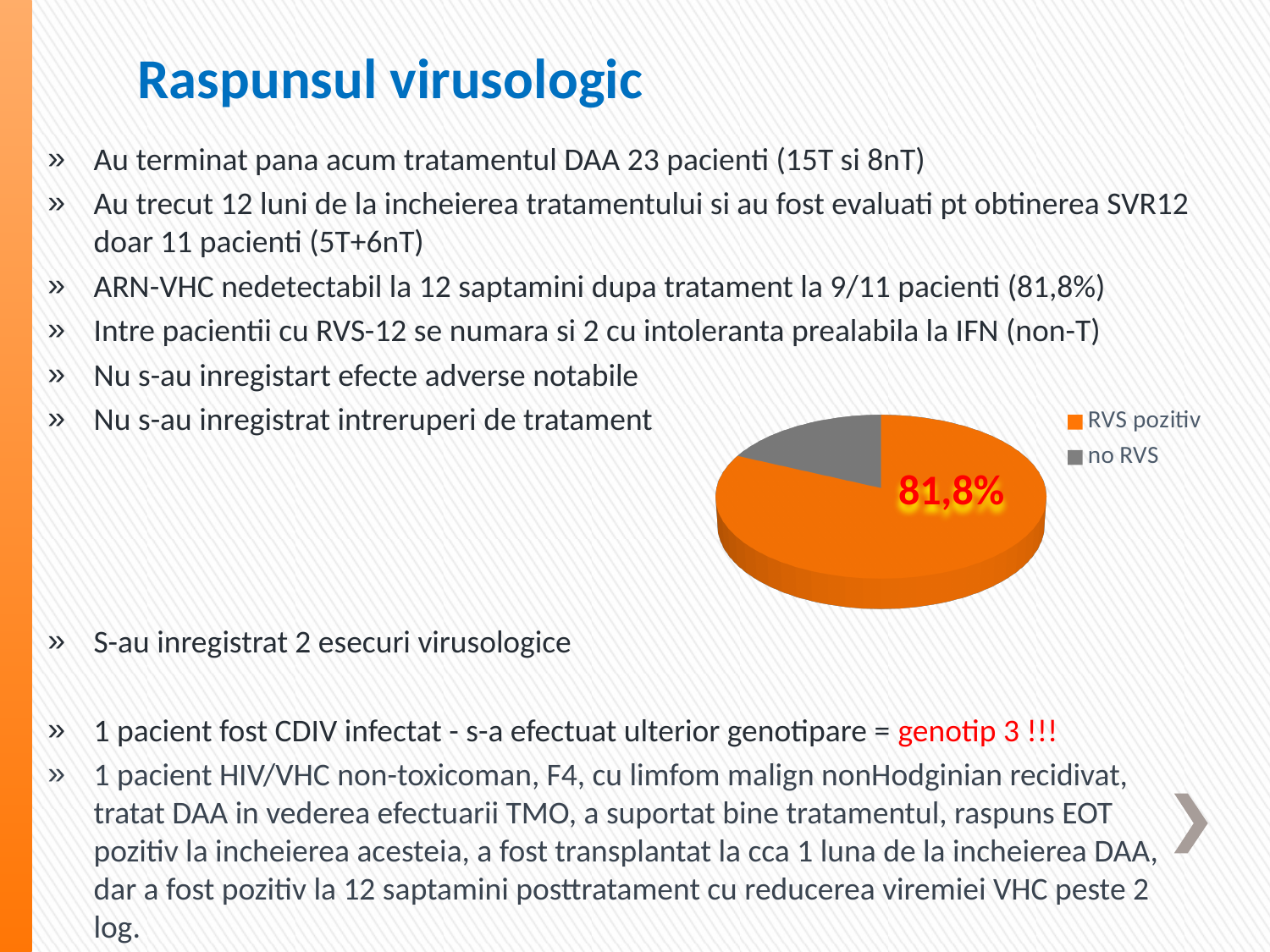
What percentage is shown for the RVS pozitiv slice of the pie chart? 81,8% Which category has the smallest slice in the pie chart? no RVS What share of the pie does the RVS pozitiv slice represent? 81,8% What kind of chart is shown on the slide? pie chart Which category has the largest slice in the pie chart? RVS pozitiv How many categories does the pie chart show? 2 What colour is the RVS pozitiv slice in the pie chart? orange How many entries does the legend of the pie chart list? 2 What colour is the no RVS slice in the pie chart? grey Which slice is larger, RVS pozitiv or no RVS? RVS pozitiv